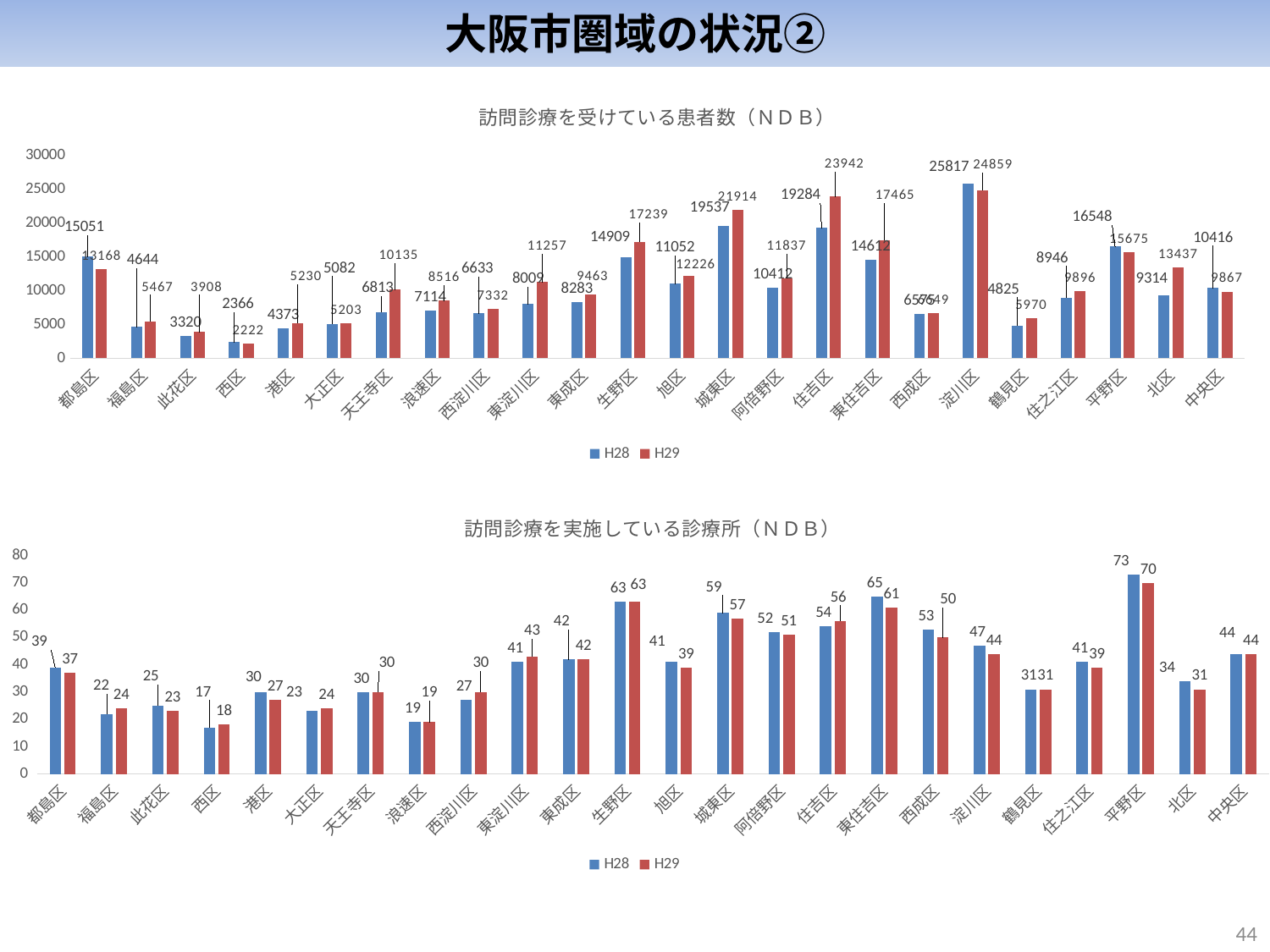
In the top chart (訪問診療を受けている患者数), which ward has the highest H28 value? 淀川区 In the bottom chart (訪問診療を実施している診療所), which ward has the highest H28 value? 平野区 How many wards are shown on the x axis of the bottom chart (訪問診療を実施している診療所)? 24 In the bottom chart (訪問診療を実施している診療所), what is the H29 value for 東住吉区? 61 In the bottom chart (訪問診療を実施している診療所), what is the difference between the H28 and H29 values for 淀川区? 3 In the top chart (訪問診療を受けている患者数), what is the H29 value for 住吉区? 23942 In the top chart (訪問診療を受けている患者数), what is the difference between the H29 and H28 values for 北区? 4123 How many series does the legend of the top chart (訪問診療を受けている患者数) list? 2 In the top chart (訪問診療を受けている患者数), which ward has the lowest H29 value? 西区 In the top chart (訪問診療を受けている患者数), what is the H28 value for 城東区? 19537 In the bottom chart (訪問診療を実施している診療所), which ward has the lowest H28 value? 西区 In the top chart (訪問診療を受けている患者数), which is larger for 平野区, the H28 value or the H29 value? H28